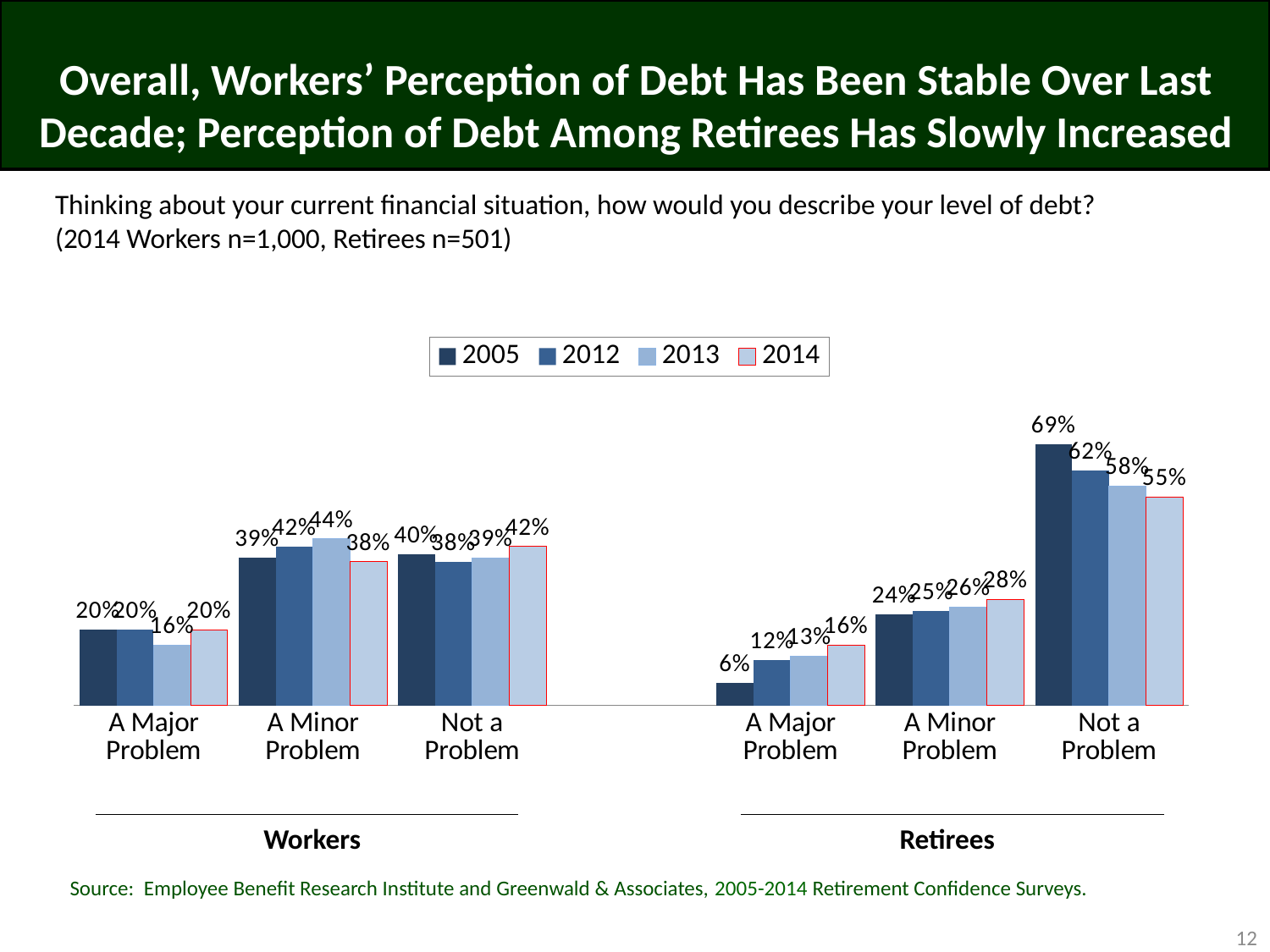
What kind of chart is shown on the slide? Bar chart For retirees, do the values for 'A Major Problem' rise or fall from 2005 to 2014? Rise For retirees, which year has the highest value for 'Not a Problem'? 2005 What percentage of workers said debt was a minor problem in 2013? 44% How many series does the legend list? 4 Which series is drawn with a red outline in the legend? 2014 What is the difference between the 2005 and 2014 values for retirees saying debt is not a problem? 14 percentage points What percentage of retirees said debt was not a problem in 2005? 69% What percentage of retirees said debt was a major problem in 2014? 16% What percentage of workers said debt was a major problem in 2013? 16% Which is larger: the 2014 value for workers saying debt is not a problem, or the 2014 value for workers saying debt is a minor problem? Not a Problem (42%) For retirees, which year has the lowest value for 'A Major Problem'? 2005